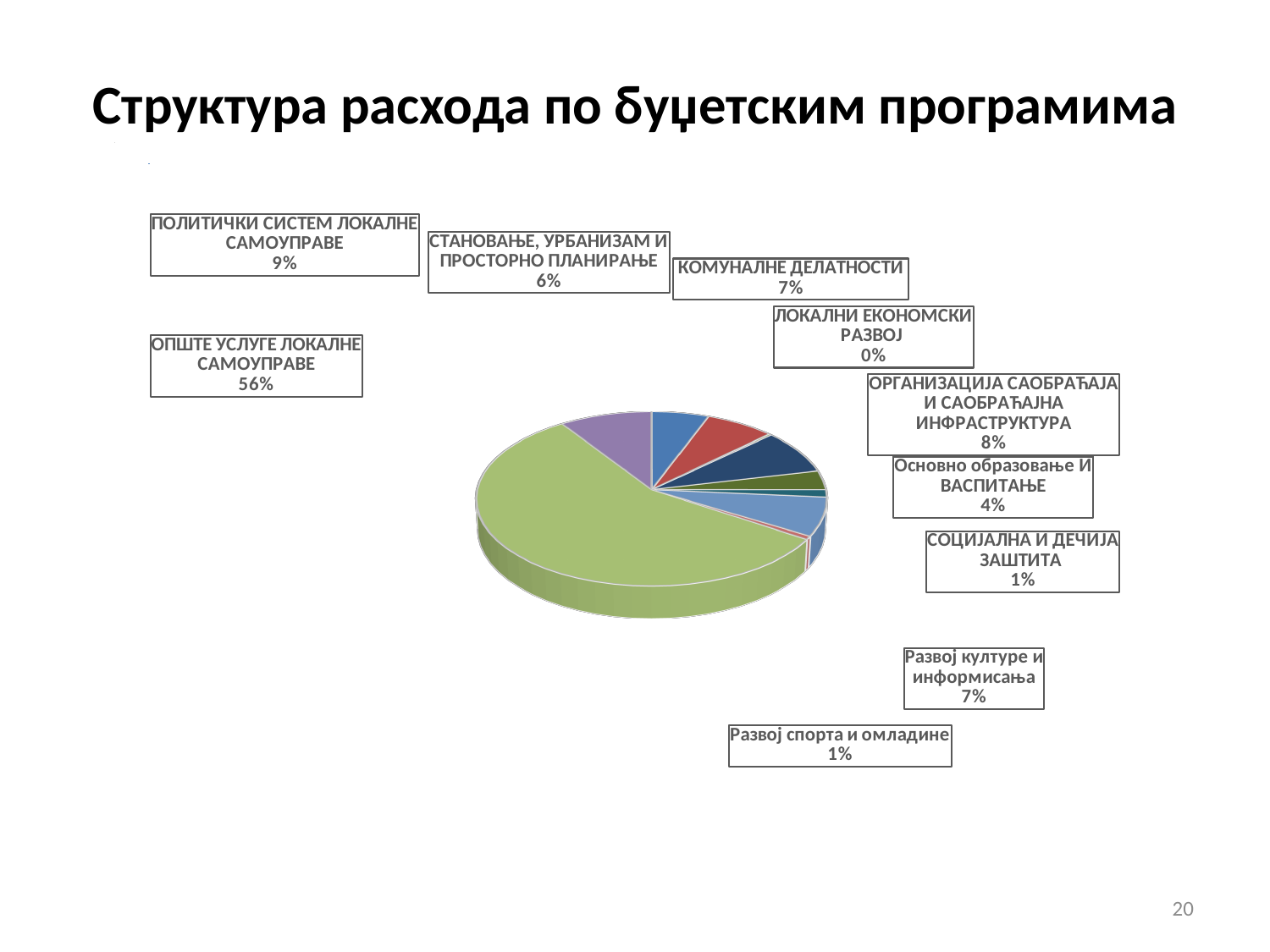
Which category has the largest share of the pie? ОПШТЕ УСЛУГЕ ЛОКАЛНЕ САМОУПРАВЕ How many categories (slices) are labelled in the pie chart? 10 What is the difference in percentage points between ОПШТЕ УСЛУГЕ ЛОКАЛНЕ САМОУПРАВЕ and ПОЛИТИЧКИ СИСТЕМ ЛОКАЛНЕ САМОУПРАВЕ? 47 What percentage is shown for ОРГАНИЗАЦИЈА САОБРАЋАЈА И САОБРАЋАЈНА ИНФРАСТРУКТУРА? 8% Which has a larger share: КОМУНАЛНЕ ДЕЛАТНОСТИ or Основно образовање И ВАСПИТАЊЕ? КОМУНАЛНЕ ДЕЛАТНОСТИ Which category has the smallest share of the pie? ЛОКАЛНИ ЕКОНОМСКИ РАЗВОЈ What percentage is shown for Основно образовање И ВАСПИТАЊЕ? 4% What kind of chart is shown on the slide? Pie chart What percentage is shown for ПОЛИТИЧКИ СИСТЕМ ЛОКАЛНЕ САМОУПРАВЕ? 9% What is the title of the chart on the slide? Структура расхода по буџетским програмима What share of the pie does ОПШТЕ УСЛУГЕ ЛОКАЛНЕ САМОУПРАВЕ have? 56% What percentage is shown for СТАНОВАЊЕ, УРБАНИЗАМ И ПРОСТОРНО ПЛАНИРАЊЕ? 6%